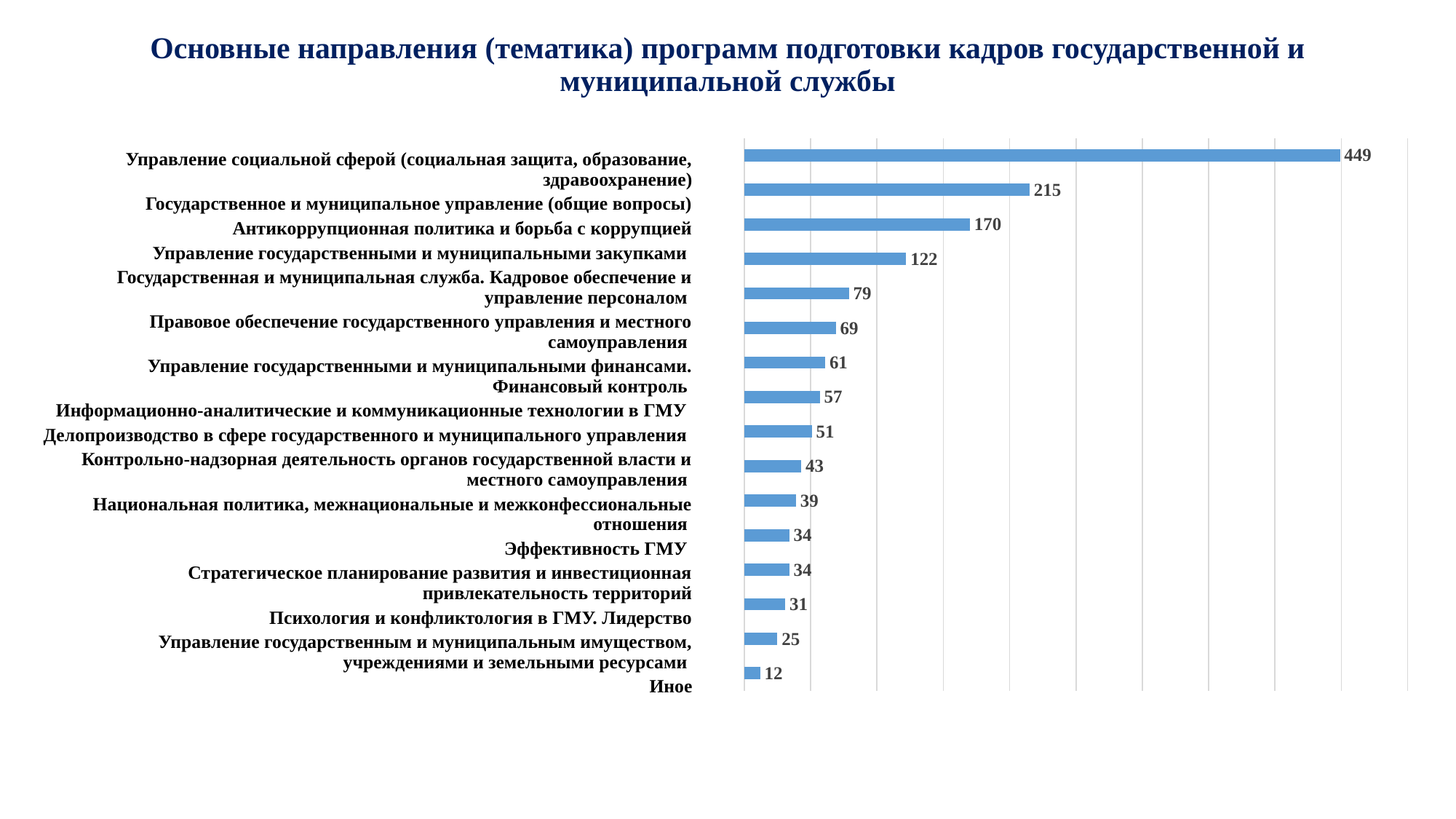
What is the difference between the values for "Управление социальной сферой (социальная защита, образование, здравоохранение)" and "Государственное и муниципальное управление (общие вопросы)"? 234 Which is larger: the value for "Эффективность ГМУ" or the value for "Управление государственным и муниципальным имуществом, учреждениями и земельными ресурсами"? Эффективность ГМУ What type of chart is shown on the slide? bar chart What is the value for "Иное"? 12 What is the value for "Антикоррупционная политика и борьба с коррупцией"? 170 What is the difference between the values for "Правовое обеспечение государственного управления и местного самоуправления" and "Делопроизводство в сфере государственного и муниципального управления"? 18 What is the value for "Управление государственными и муниципальными закупками"? 122 What is the value for "Психология и конфликтология в ГМУ. Лидерство"? 31 Which category has the lowest value? Иное What is the title of the slide? Основные направления (тематика) программ подготовки кадров государственной и муниципальной службы How many categories are shown in the chart? 16 Which category has the highest value? Управление социальной сферой (социальная защита, образование, здравоохранение)